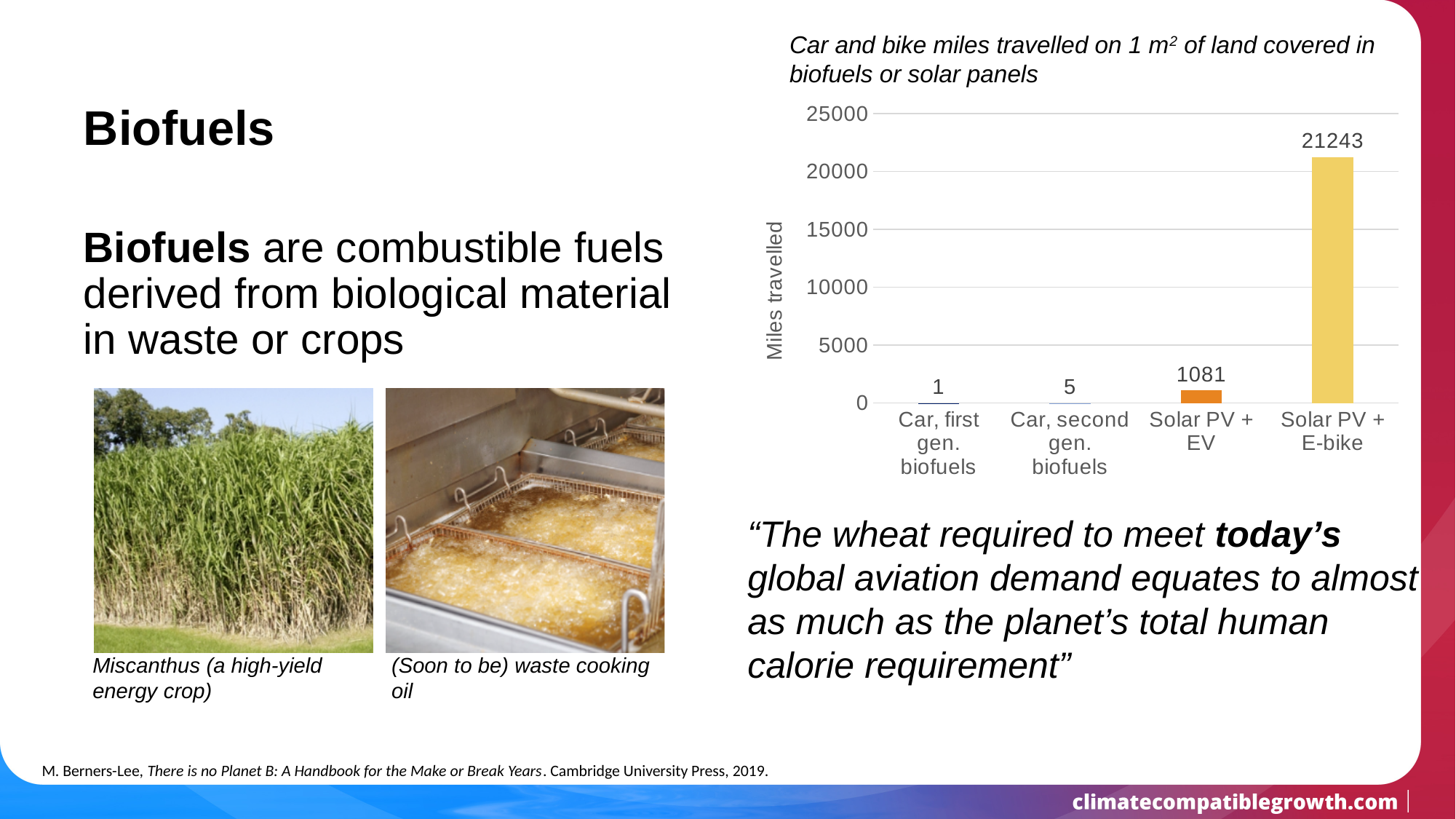
What is the value for Solar PV + E-bike? 21243 What is the difference between Car, second gen. biofuels and Car, first gen. biofuels? 4 Which is larger, Solar PV + EV or Car, second gen. biofuels? Solar PV + EV How many categories are shown on the chart? 4 What is the value for Car, first gen. biofuels? 1 What is the value for Car, second gen. biofuels? 5 What is the difference between Solar PV + E-bike and Solar PV + EV? 20162 Is the value for Solar PV + E-bike greater or less than 20000? greater What is the value for Solar PV + EV? 1081 Which category has the highest miles travelled? Solar PV + E-bike Which category has the lowest miles travelled? Car, first gen. biofuels What kind of chart is shown on the slide? bar chart